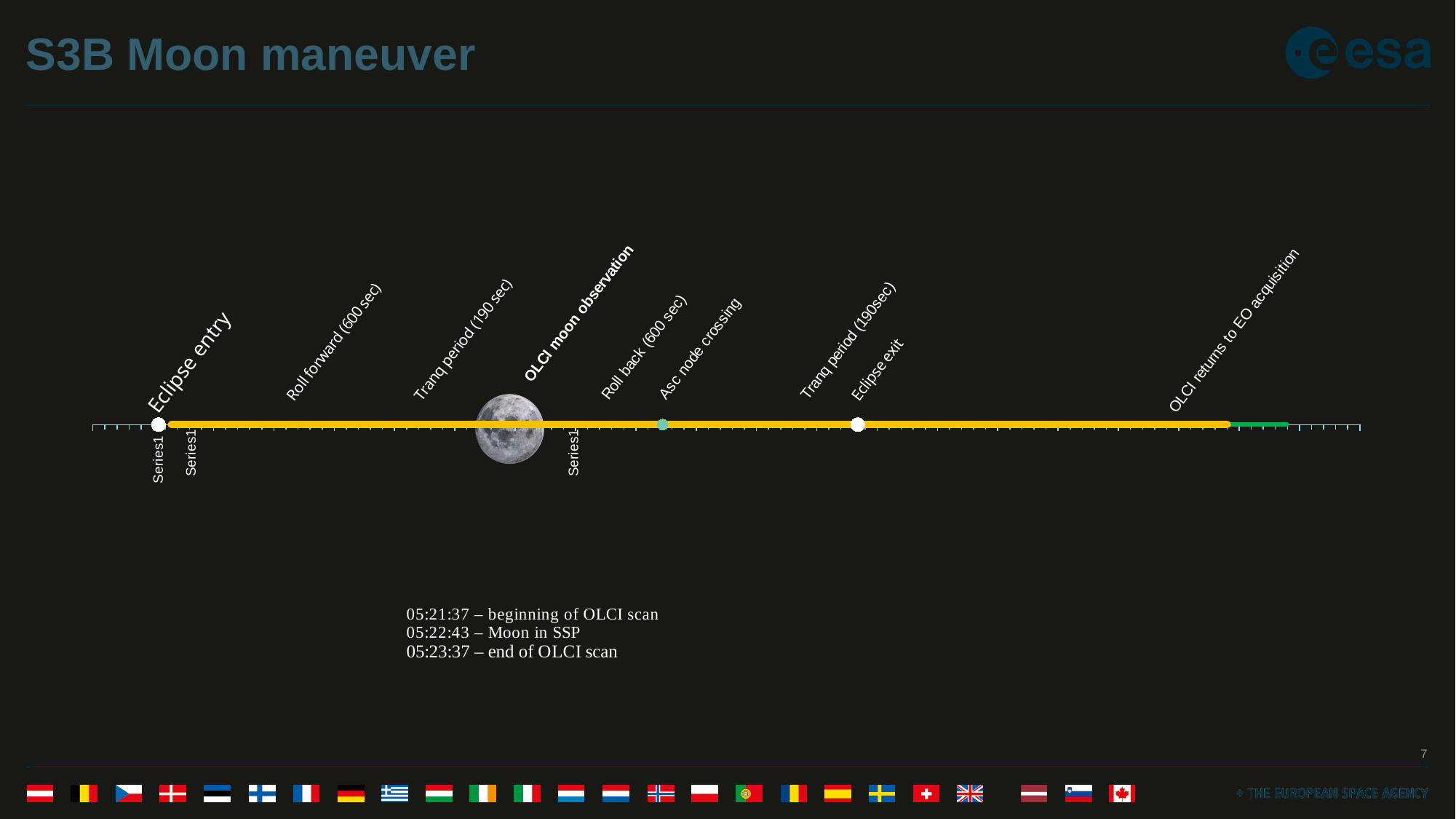
How many labeled events are marked along the timeline? 9 How long is the Roll forward period according to its label? 600 sec What is the combined duration of the Roll forward and Roll back periods? 1200 sec What is the difference in seconds between the Roll forward period and the Tranq period? 410 sec What kind of chart is shown on the slide? Timeline chart Which event is the last on the timeline? OLCI returns to EO acquisition Which event is the first on the timeline? Eclipse entry How long is the Tranq period before the OLCI moon observation? 190 sec Which is longer, the Roll forward period or the Tranq period? Roll forward What colour is the final segment of the timeline after the orange line? Green How long is the Roll back period according to its label? 600 sec What is the title of the slide containing the timeline? S3B Moon maneuver